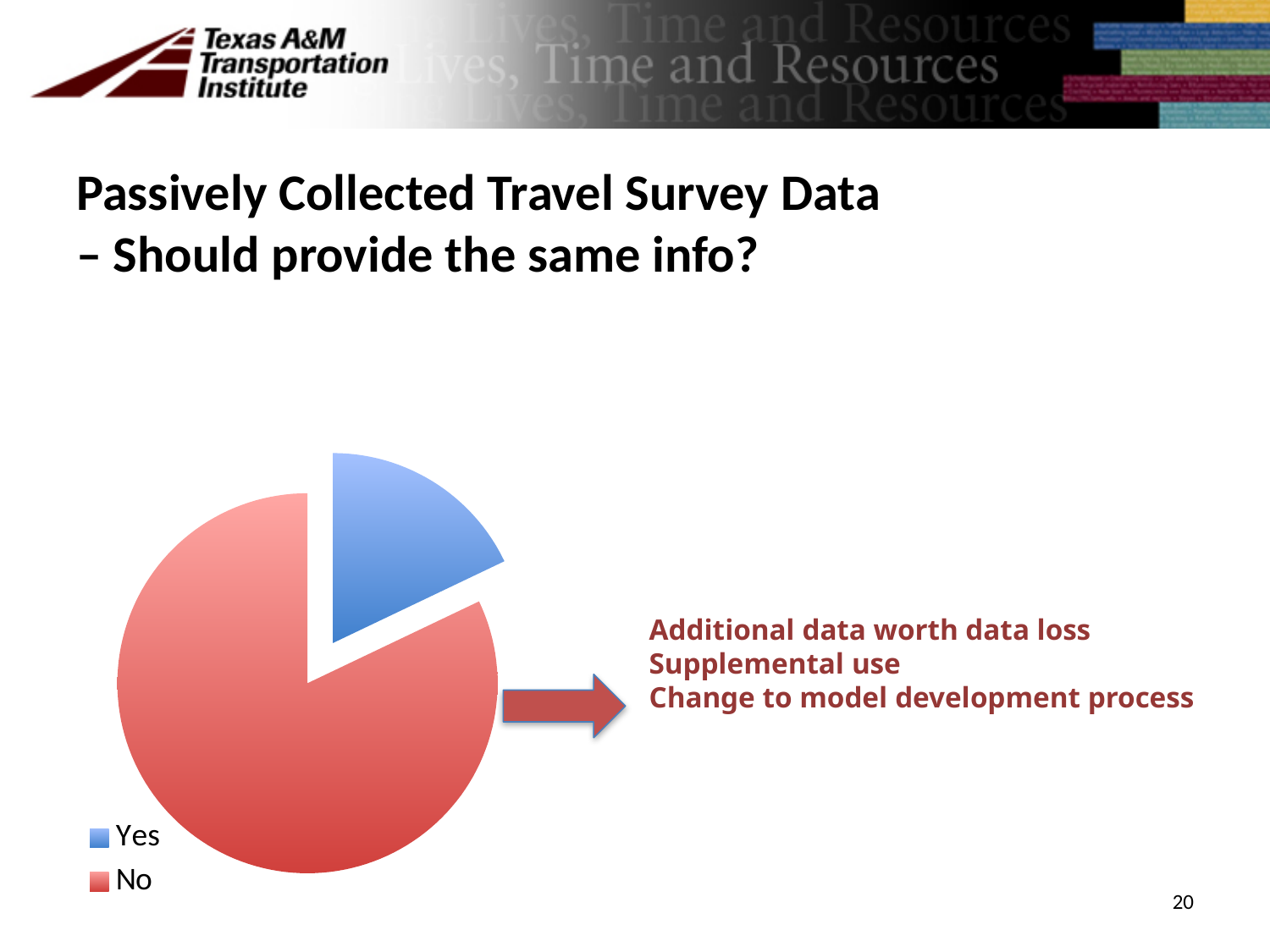
Which category has the smallest slice of the pie chart? Yes What colour is the Yes slice in the pie chart? Blue Which category has the largest slice of the pie chart? No What kind of chart is shown on the slide? Pie chart How many slices does the pie chart have? 2 How many entries does the legend of the pie chart list? 2 Is the Yes slice larger or smaller than the No slice? Smaller Which slice of the pie chart is pulled out (exploded) from the rest of the pie? Yes Which slice is larger in the pie chart, Yes or No? No